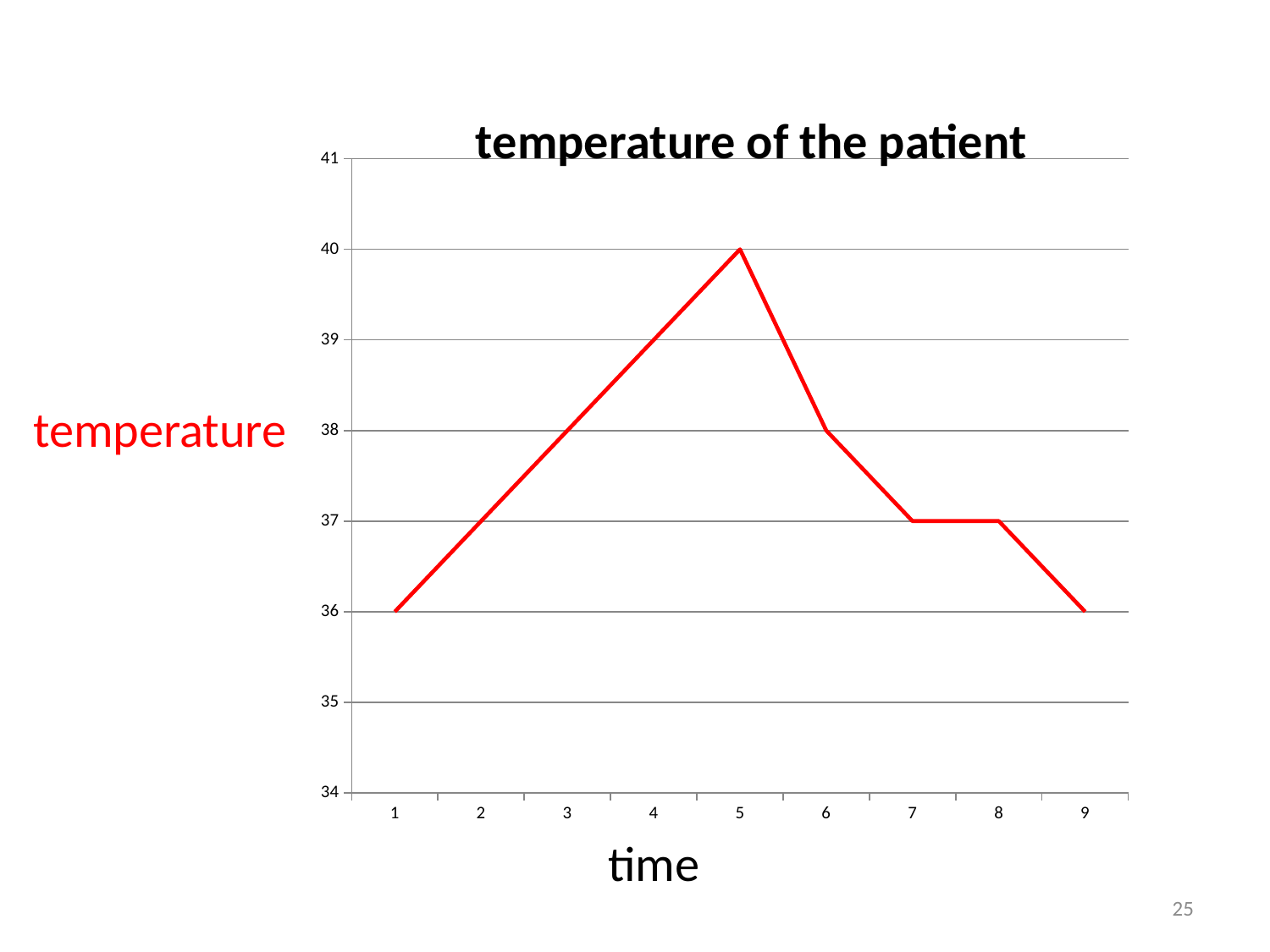
What is the label of the x axis? time What is the title of the chart? temperature of the patient What kind of chart is shown on the slide? line chart What is the temperature at time 7? 37 What is the temperature at time 1? 36 What is the temperature at time 6? 38 How many time points are plotted on the x axis? 9 What is the difference between the temperature at time 5 and the temperature at time 9? 4 Which is higher, the temperature at time 6 or at time 8? time 6 At which time is the temperature highest? 5 What is the temperature at time 9? 36 What is the temperature at time 5? 40